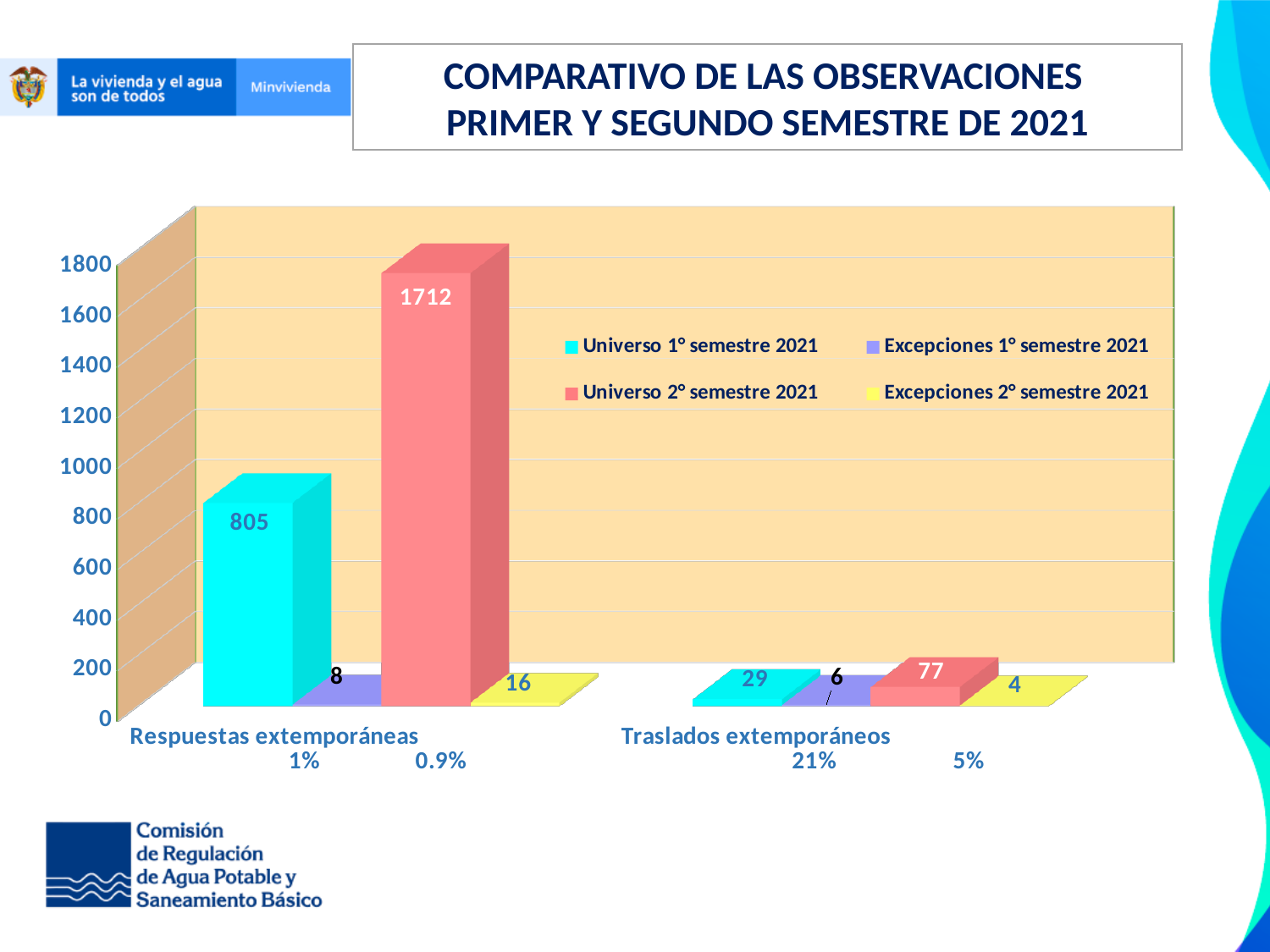
How many categories are shown on the x axis? 2 What kind of chart is shown on the slide? Bar chart What is the value of Excepciones 2° semestre 2021 for Traslados extemporáneos? 4 What is the value of Universo 2° semestre 2021 for Traslados extemporáneos? 77 What is the value of Universo 1° semestre 2021 for Respuestas extemporáneas? 805 What is the difference between Universo 2° semestre 2021 and Universo 1° semestre 2021 for Respuestas extemporáneas? 907 Which is larger for Traslados extemporáneos: Universo 1° semestre 2021 or Universo 2° semestre 2021? Universo 2° semestre 2021 Which series has the highest value for Respuestas extemporáneas? Universo 2° semestre 2021 How many series does the legend list? 4 What is the value of Excepciones 1° semestre 2021 for Respuestas extemporáneas? 8 Which series has the lowest value for Traslados extemporáneos? Excepciones 2° semestre 2021 What is the value of Universo 2° semestre 2021 for Respuestas extemporáneas? 1712